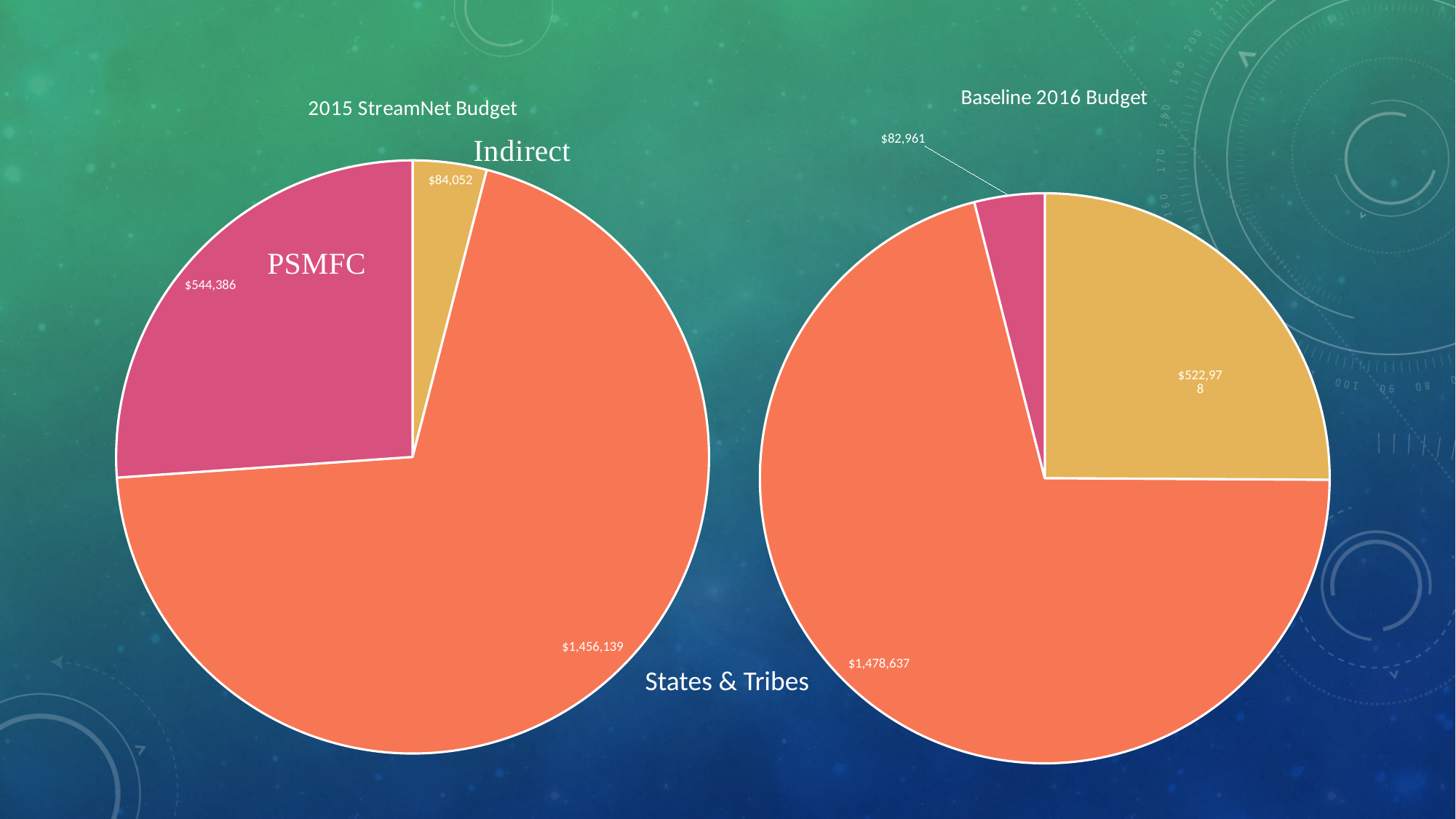
In the 2015 StreamNet Budget chart, what is the value for Indirect? $84,052 In the 2015 StreamNet Budget chart, what is the difference between the PSMFC and Indirect values? $460,334 In the 2015 StreamNet Budget chart, which category has the largest slice? States & Tribes In the 2015 StreamNet Budget chart, what is the total of all three slices? $2,084,577 What type of chart is the 2015 StreamNet Budget chart? Pie chart In the Baseline 2016 Budget chart, what is the value of the largest slice? $1,478,637 How many slices does the Baseline 2016 Budget chart have? 3 In the Baseline 2016 Budget chart, what is the value of the smallest slice? $82,961 In the 2015 StreamNet Budget chart, what is the value for States & Tribes? $1,456,139 In the 2015 StreamNet Budget chart, which category has the smallest slice? Indirect In the 2015 StreamNet Budget chart, what is the value for PSMFC? $544,386 In the Baseline 2016 Budget chart, what is the value of the yellow slice? $522,978